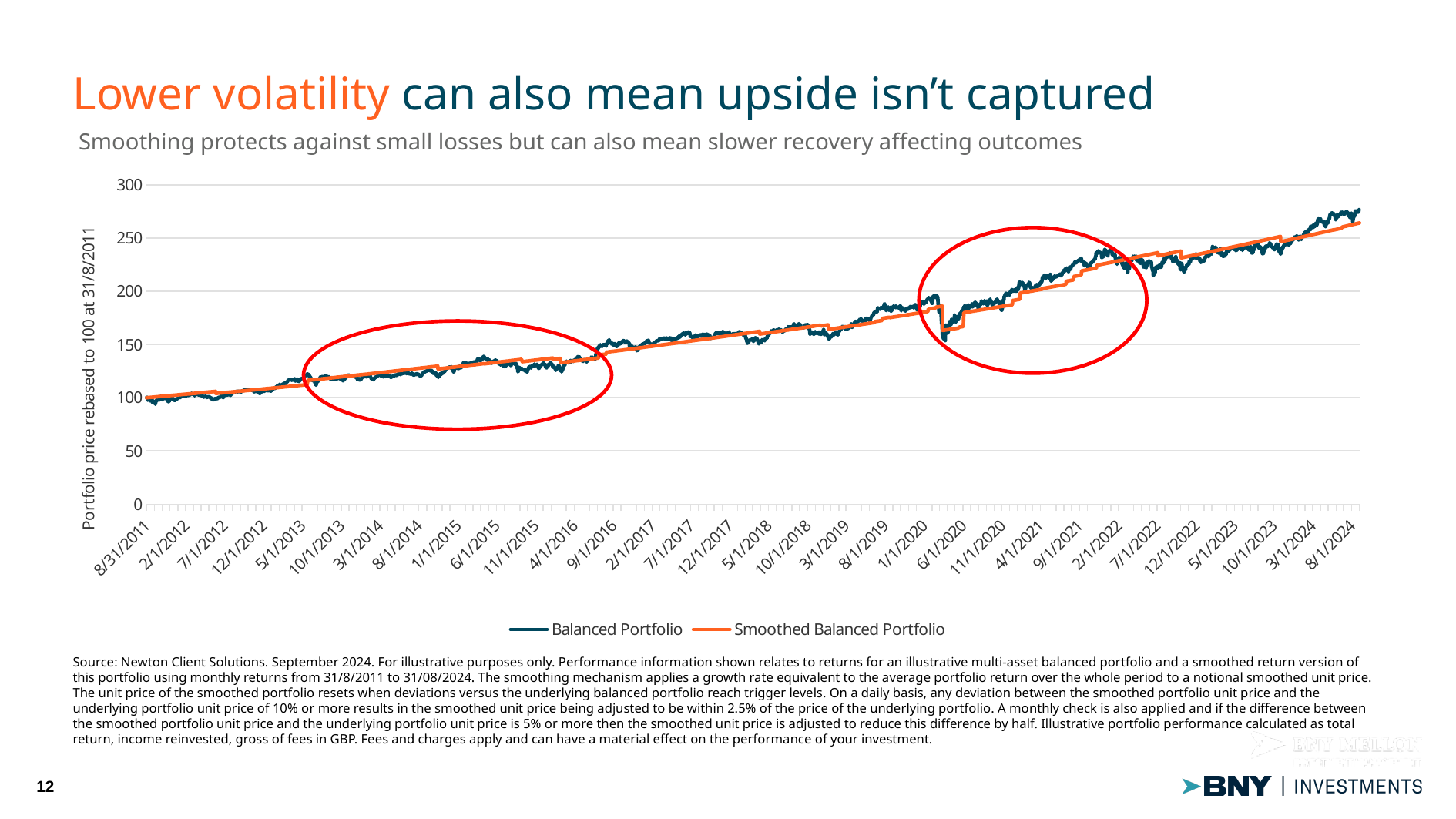
What kind of chart is shown on the slide? Line chart Is the value of the Smoothed Balanced Portfolio at 1/1/2015 greater or less than 150? less Is the value of the Balanced Portfolio at 8/1/2024 greater or less than 300? less Around 9/1/2021, which series has the higher value: Balanced Portfolio or Smoothed Balanced Portfolio? Balanced Portfolio Is the value of the Balanced Portfolio at 8/1/2024 greater or less than 250? greater Around 6/1/2020, which series has the higher value: Balanced Portfolio or Smoothed Balanced Portfolio? Smoothed Balanced Portfolio What colour is the Smoothed Balanced Portfolio line? Orange How many series does the chart legend list? 2 Do the portfolio values generally rise or fall from 8/31/2011 to 8/1/2024? Rise What is the highest value shown on the vertical axis of the chart? 300 What are the two series named in the chart legend? Balanced Portfolio and Smoothed Balanced Portfolio